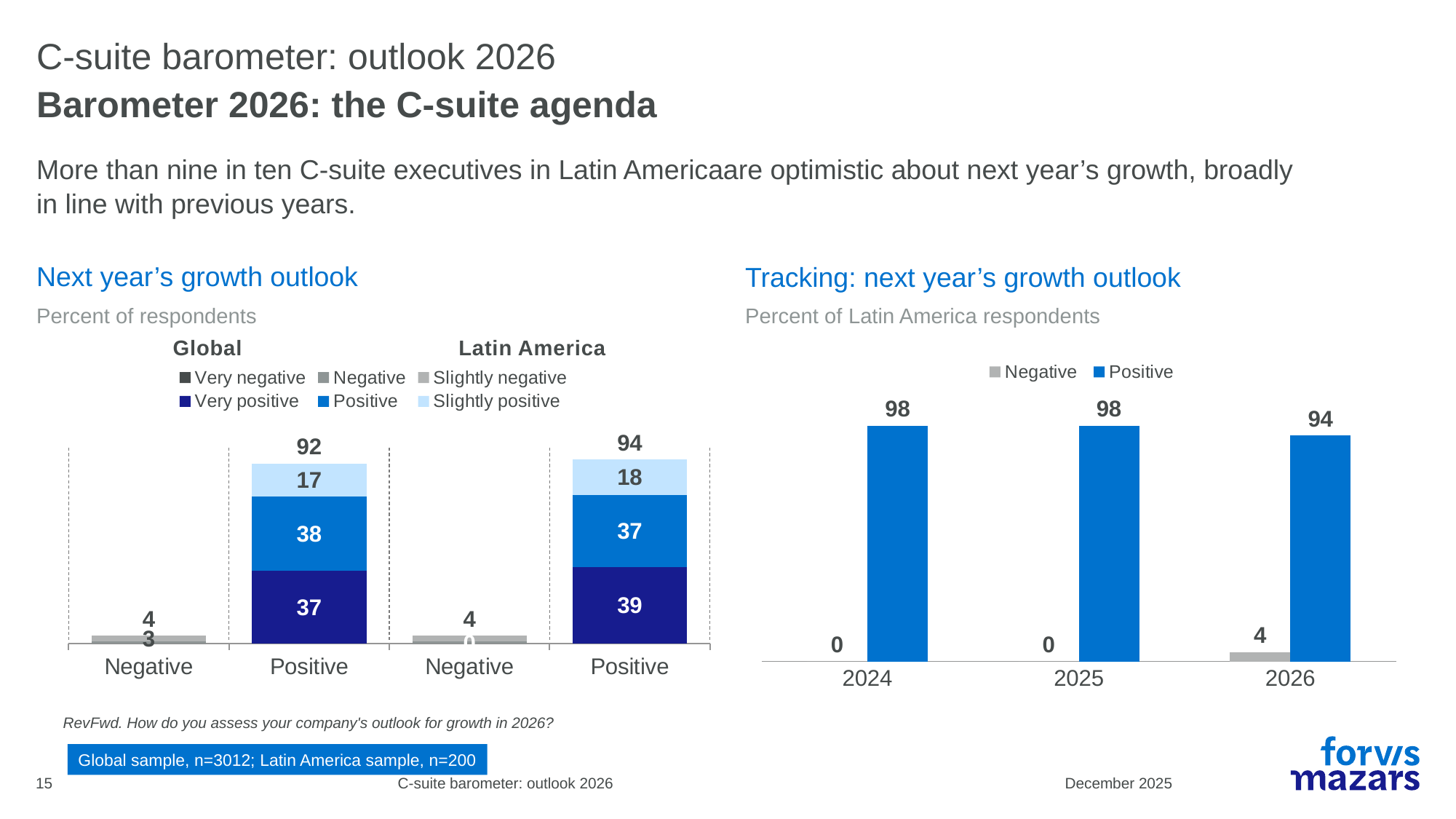
In the 'Next year's growth outlook' chart, how many series does the legend list? 6 In the 'Next year's growth outlook' chart, what is the Slightly positive value for Global? 17 In the 'Tracking: next year's growth outlook' chart, does the Positive value rise or fall from 2025 to 2026? fall In the 'Tracking: next year's growth outlook' chart, what is the Positive value for 2024? 98 In the 'Tracking: next year's growth outlook' chart, how many years are shown on the x axis? 3 In the 'Tracking: next year's growth outlook' chart, what is the Positive value for 2026? 94 In the 'Next year's growth outlook' chart, which is larger: the Positive total for Global or for Latin America? Latin America In the 'Next year's growth outlook' chart, what is the Very positive value for Latin America? 39 In the 'Next year's growth outlook' chart, what is the total of the Positive stacked bar for Latin America? 94 In the 'Tracking: next year's growth outlook' chart, how many series does the legend list? 2 In the 'Tracking: next year's growth outlook' chart, what is the Negative value for 2026? 4 In the 'Tracking: next year's growth outlook' chart, what is the difference between the Positive values for 2025 and 2026? 4